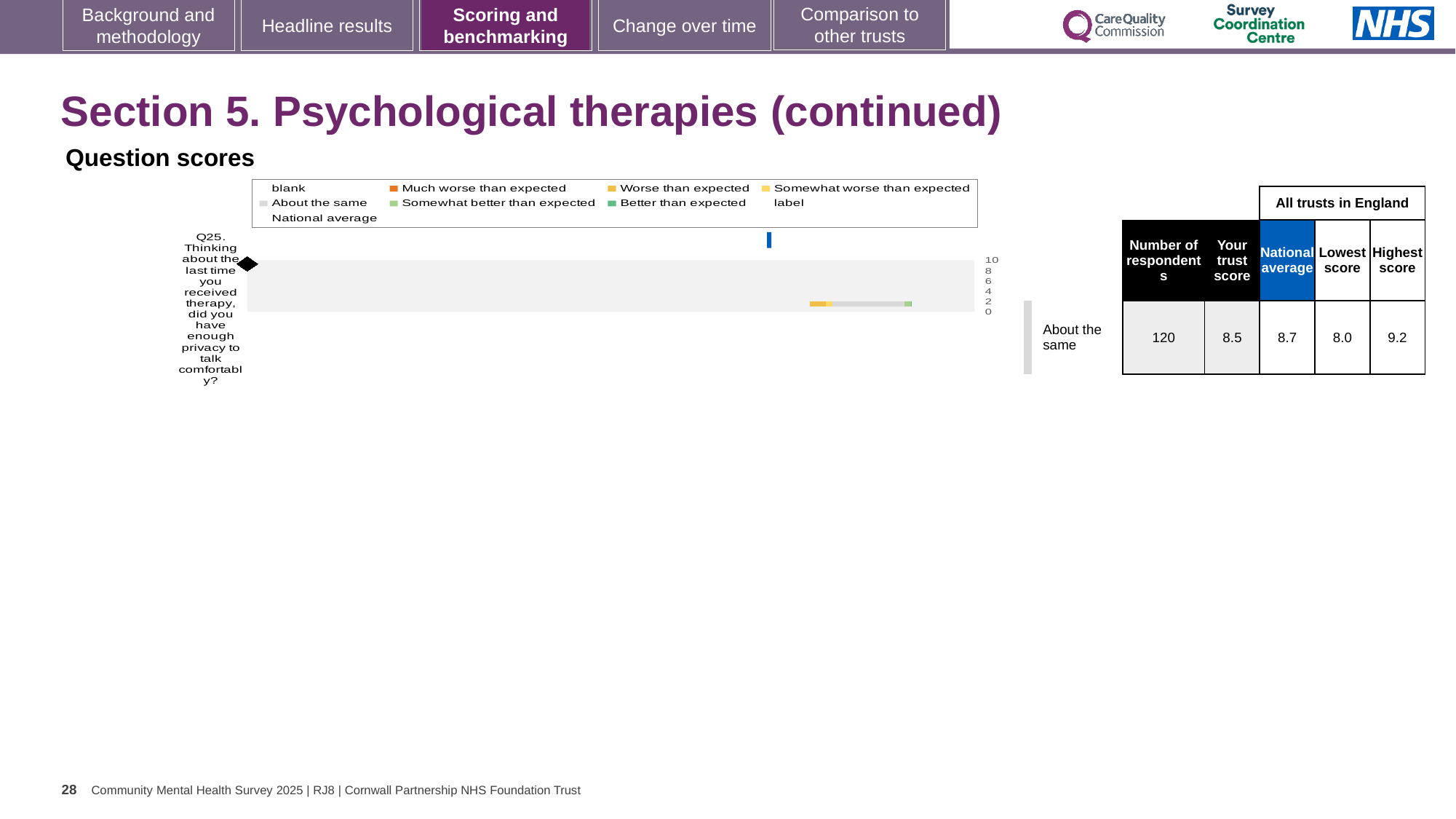
Which question is plotted on the chart? Q25. Thinking about the last time you received therapy, did you have enough privacy to talk comfortably? What benchmark category is the trust's Q25 score placed in? About the same Which is larger for Q25, the trust score or the national average? national average What is the highest tick value shown on the chart's axis? 10 How many questions (categories) are plotted on the chart? 1 According to the table beside the chart, how many respondents answered Q25? 120 According to the table beside the chart, what is the highest score among all trusts in England for Q25? 9.2 According to the table beside the chart, what is the trust's score for Q25? 8.5 What kind of chart is shown on the slide? bar chart According to the table beside the chart, what is the national average for Q25? 8.7 What is the difference between the highest score and the lowest score for Q25? 1.2 According to the table beside the chart, what is the lowest score among all trusts in England for Q25? 8.0